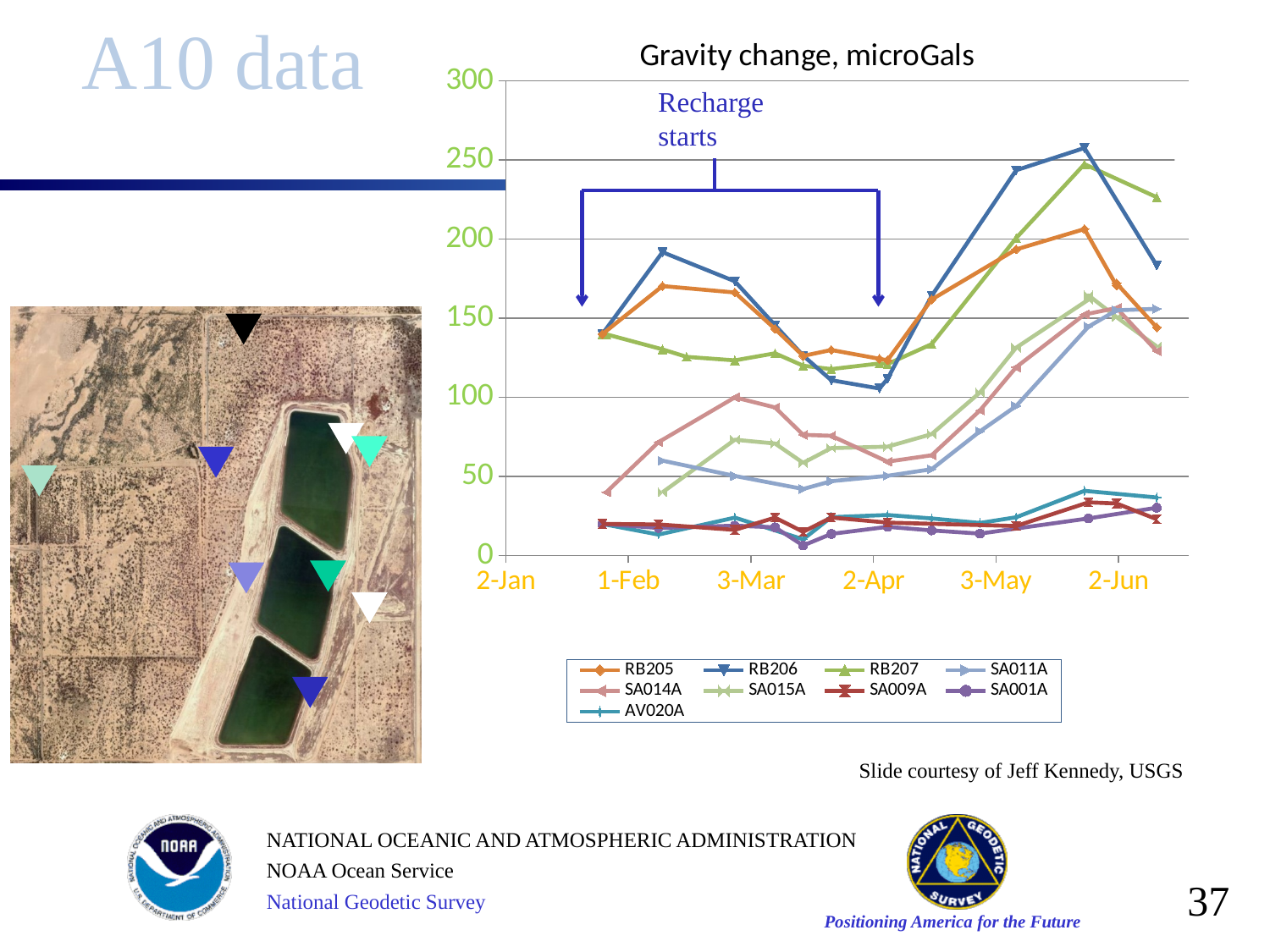
Is the value for SA001A at 3-May greater or less than 50? less Does RB206 rise or fall between 2-Apr and 3-May? rise How many date labels are shown along the x axis? 6 Which series reaches the highest value on the chart? RB206 What label is written above the bracket spanning 1-Feb to 2-Apr? Recharge starts At 2-Jun, which is higher, RB207 or RB205? RB207 Is the value for RB205 at 1-Feb greater or less than 100? greater Is the peak value of RB206 greater or less than 250? greater How many series does the legend list? 9 What is the title of the chart? Gravity change, microGals What kind of chart is shown on the slide? line chart